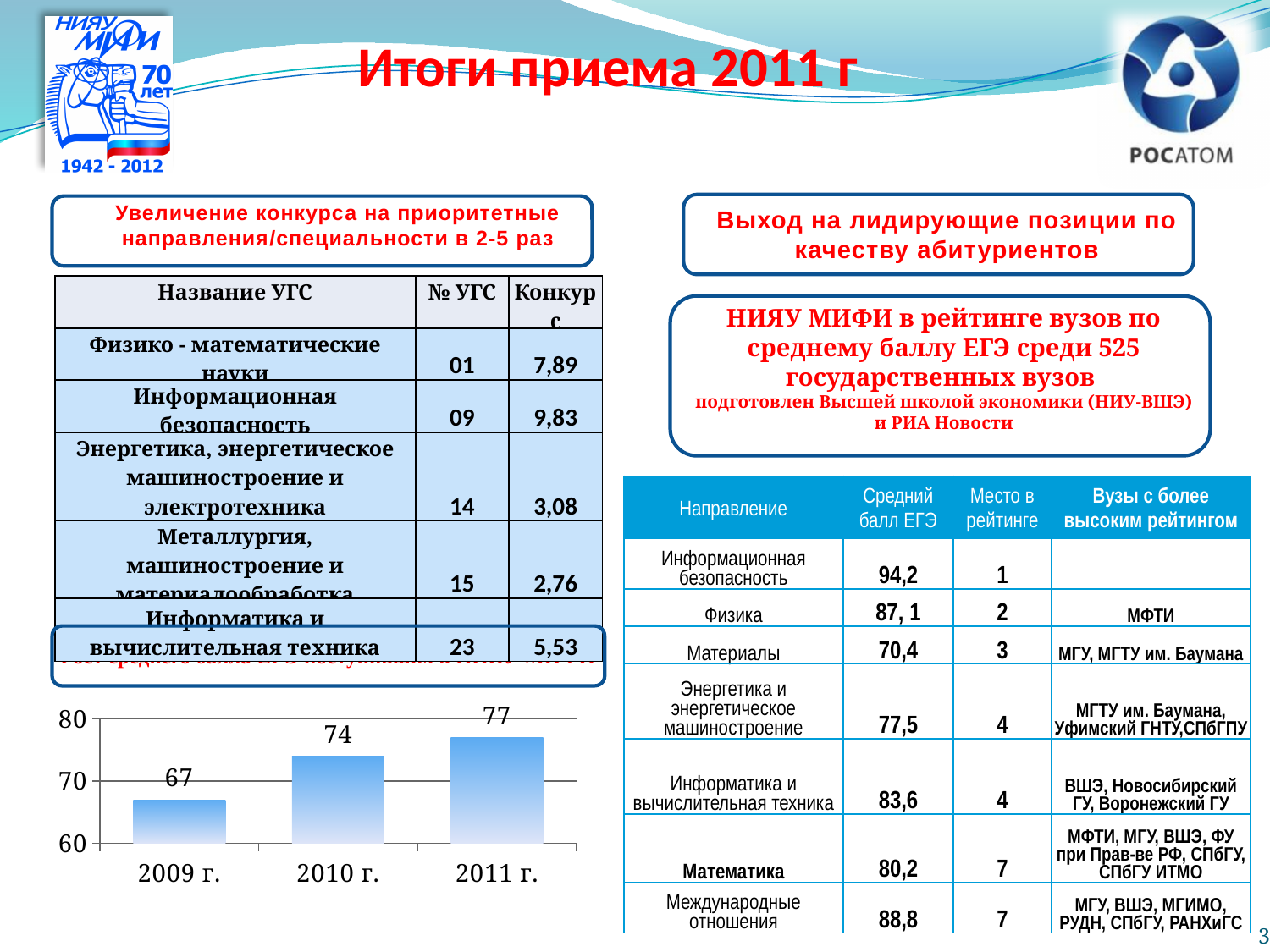
What is the value shown for 2011 г. in the bar chart? 77 How many bars are shown in the bar chart? 3 Which year has the highest value in the bar chart? 2011 г. What is the value shown for 2010 г. in the bar chart? 74 Is the value for 2009 г. in the bar chart greater or less than 70? less Which year has the lowest value in the bar chart? 2009 г. Which is larger in the bar chart, the value for 2010 г. or the value for 2011 г.? 2011 г. What kind of chart is shown at the bottom left of the slide? bar chart What is the difference between the values for 2011 г. and 2009 г. in the bar chart? 10 What is the value shown for 2009 г. in the bar chart? 67 What is the difference between the values for 2010 г. and 2009 г. in the bar chart? 7 Do the values in the bar chart rise or fall from 2009 г. to 2011 г.? rise